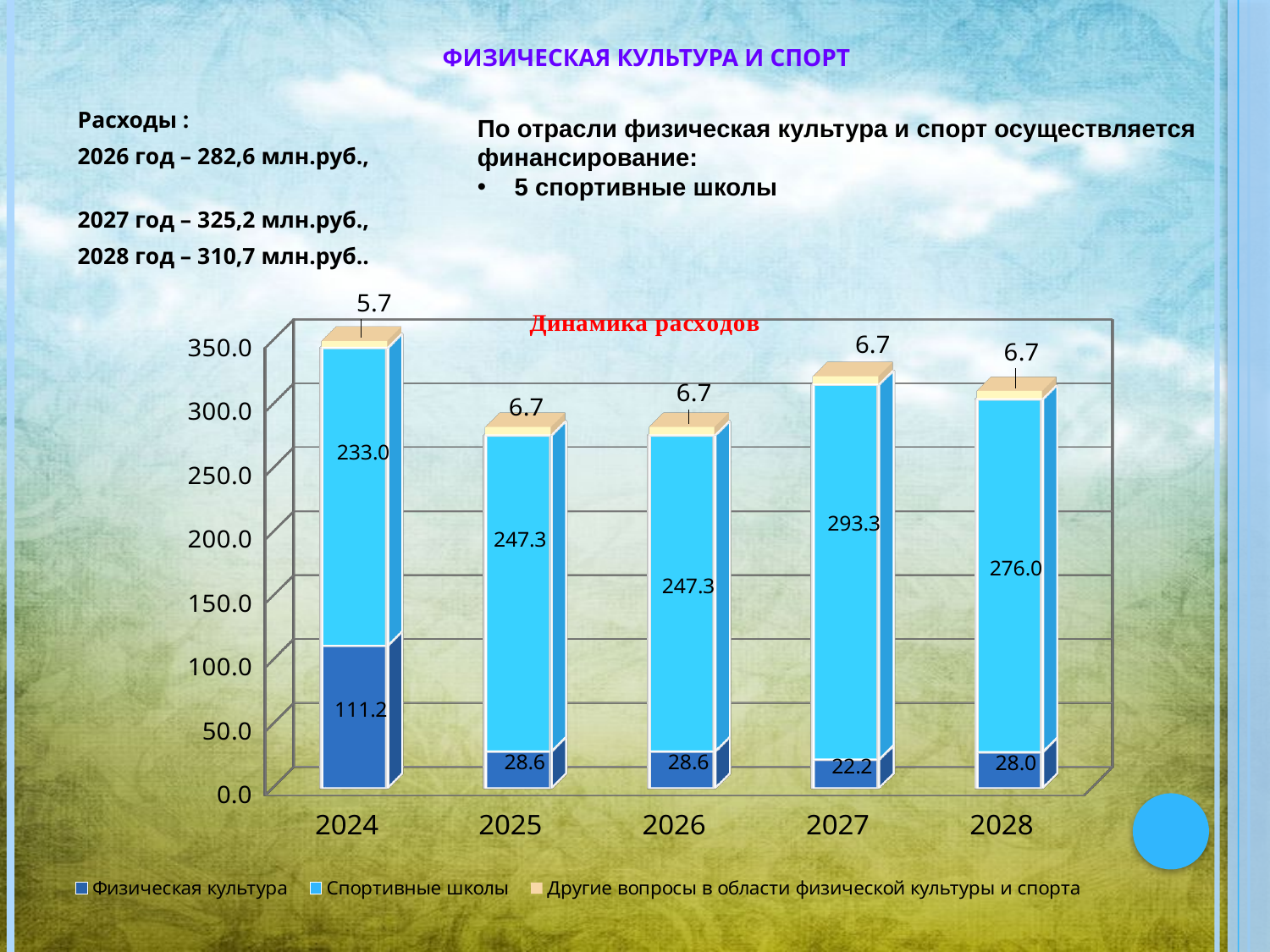
What type of chart is shown under the title "Динамика расходов"? stacked bar chart In which year is the value for "Физическая культура" the lowest? 2027 What is the total of the stacked bar for 2028? 310.7 How many series does the legend of the "Динамика расходов" chart list? 3 What is the value for "Спортивные школы" in 2027? 293.3 How many years are shown on the x axis of the "Динамика расходов" chart? 5 What is the value for "Физическая культура" in 2028? 28.0 What is the value for "Физическая культура" in 2024? 111.2 What is the difference between the "Спортивные школы" values in 2027 and 2028? 17.3 Which is larger: the "Физическая культура" value in 2024 or in 2025? 2024 What is the value for "Другие вопросы в области физической культуры и спорта" in 2024? 5.7 In which year is the value for "Спортивные школы" the highest? 2027